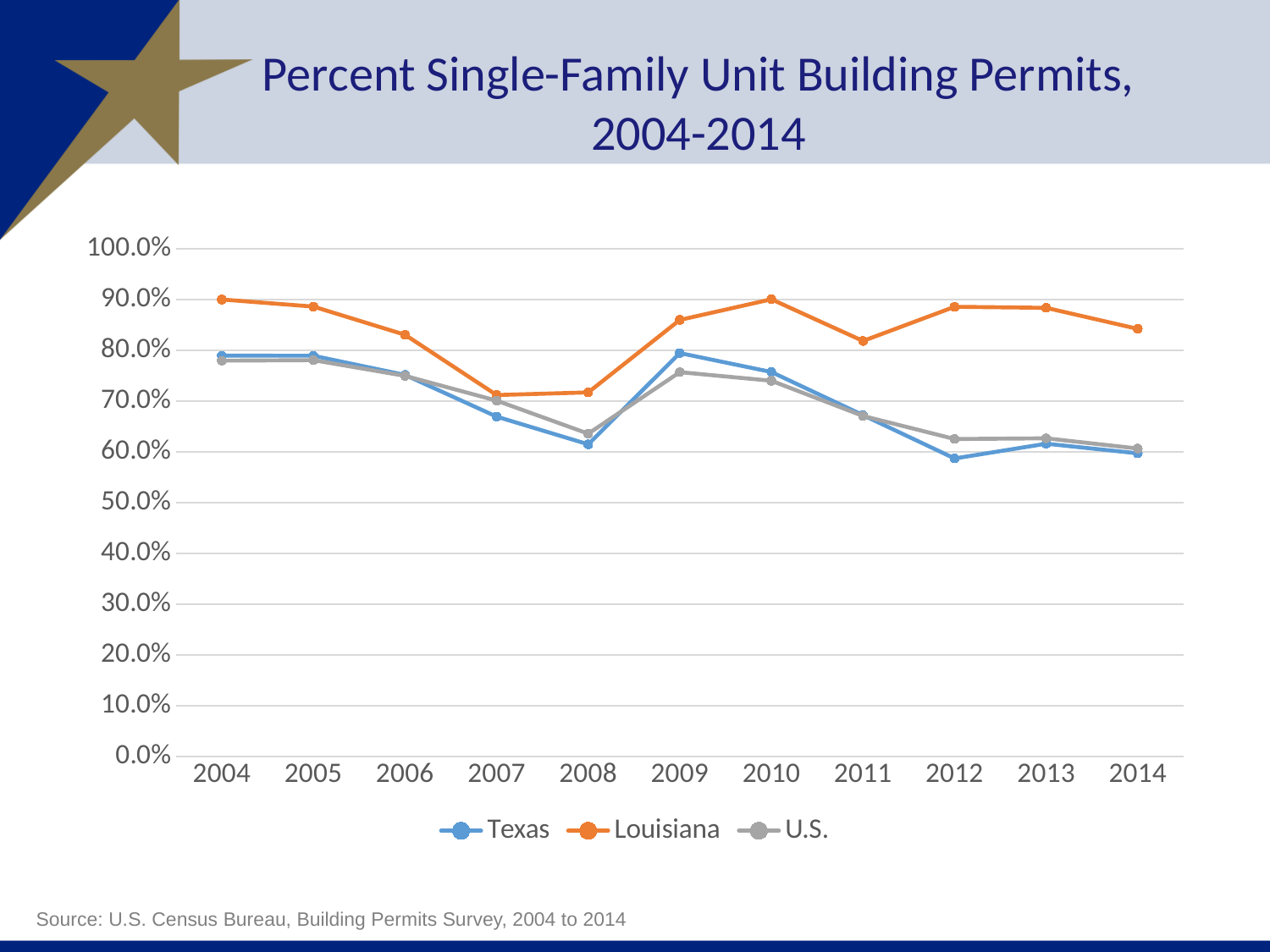
What is the title of the chart? Percent Single-Family Unit Building Permits, 2004-2014 Is the value for Louisiana in 2010 greater or less than 80.0%? greater Does the Louisiana line rise or fall from 2004 to 2007? fall Which is larger for Louisiana: the value in 2007 or the value in 2009? 2009 Which series has the highest value in 2014? Louisiana Which is larger for Texas: the value in 2004 or the value in 2014? 2004 How many years are plotted along the x axis? 11 How many series does the legend list? 3 Is the value for Texas in 2008 greater or less than 70.0%? less What kind of chart is shown on the slide? line chart Is the value for Louisiana in 2007 greater or less than 80.0%? less